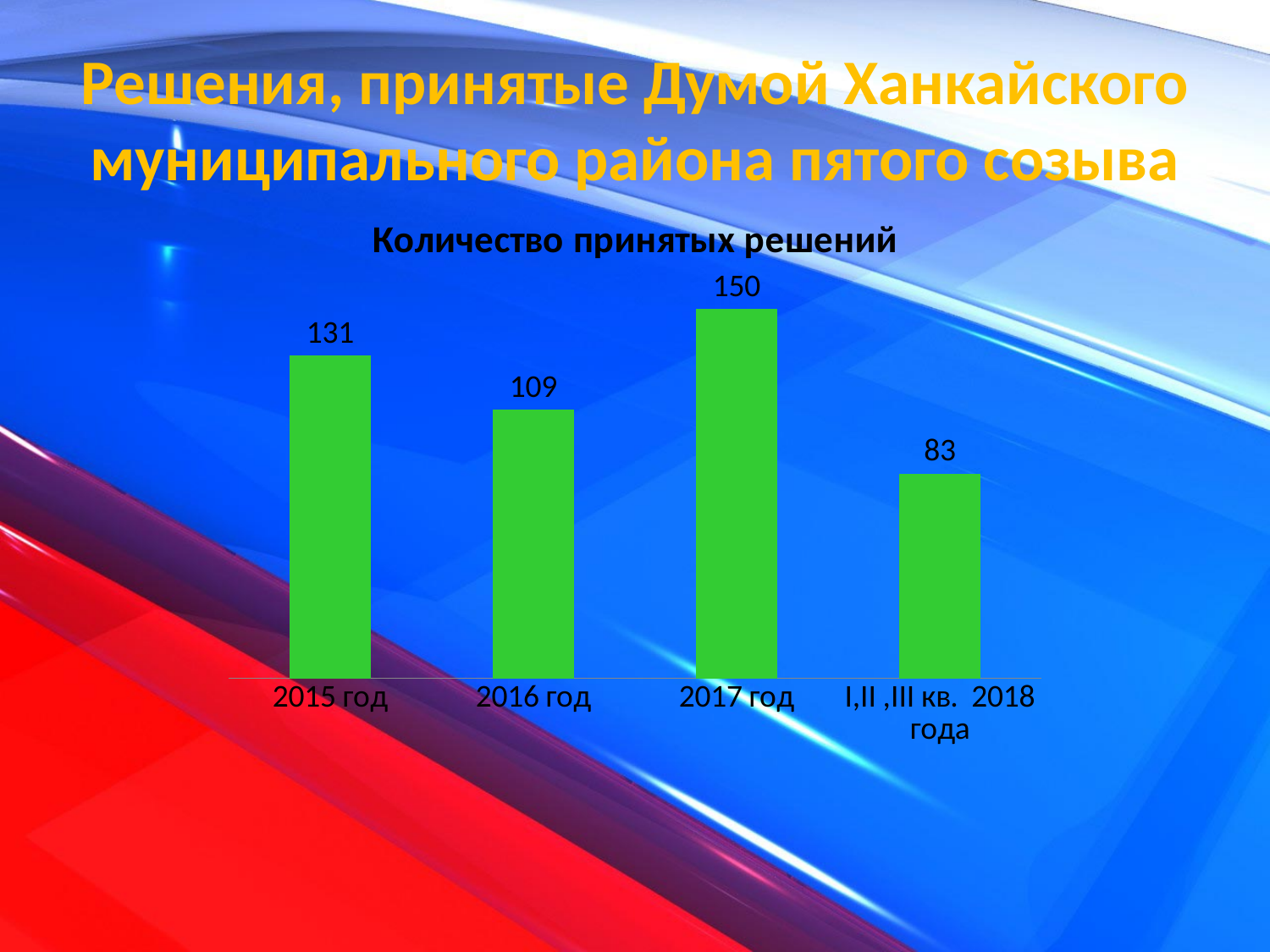
What is the value for 2016 год? 109 What is the value for 2015 год? 131 What is the difference between the values for 2015 год and I,II ,III кв. 2018 года? 48 Which category has the lowest value? I,II ,III кв. 2018 года What is the title of the chart? Количество принятых решений Which category has the highest value? 2017 год Which is larger, the value for 2015 год or the value for 2016 год? 2015 год What kind of chart is shown on the slide? bar chart What is the difference between the values for 2017 год and 2016 год? 41 What is the value for I,II ,III кв. 2018 года? 83 How many categories are shown on the chart? 4 What is the value for 2017 год? 150